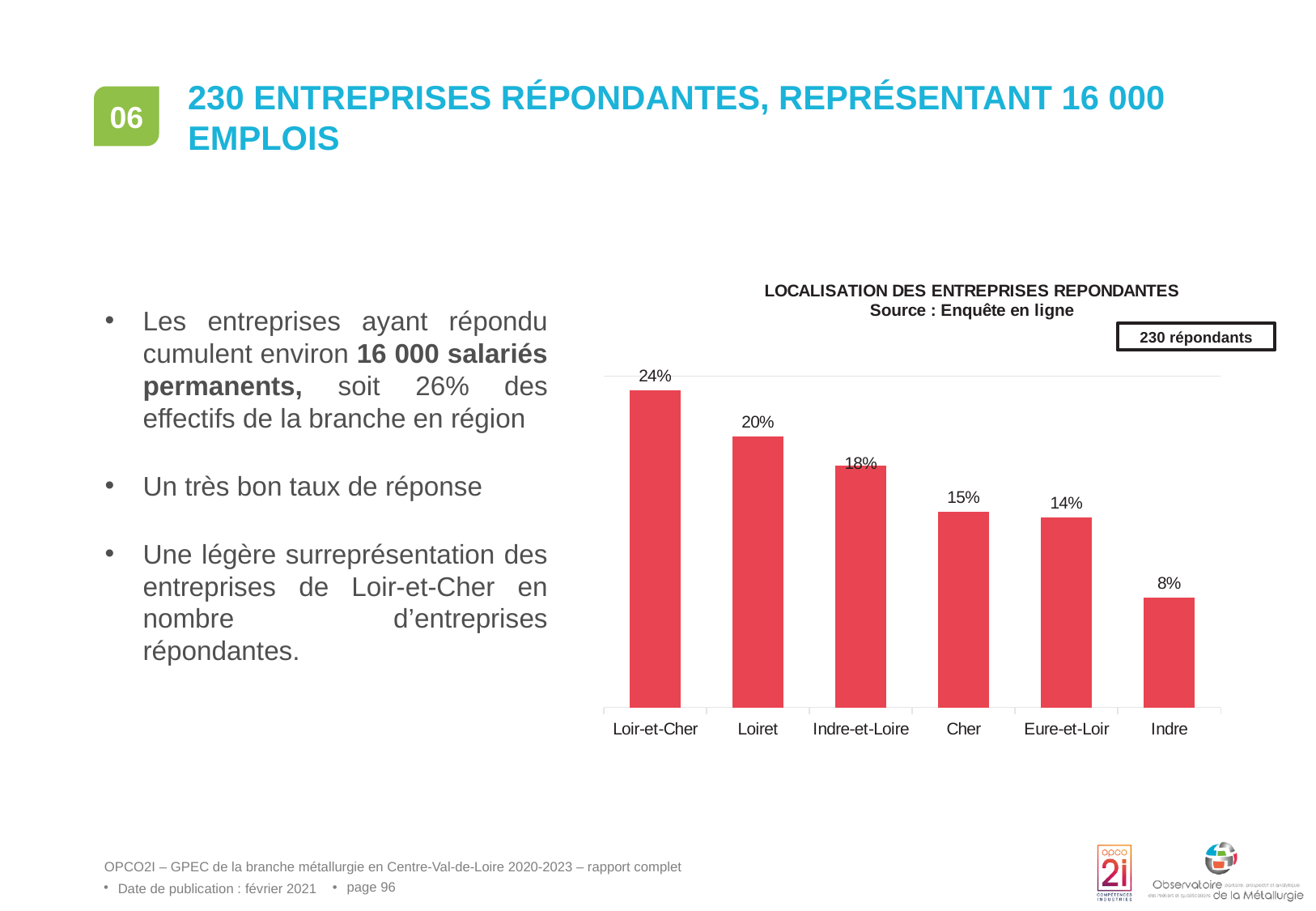
What is the difference between the values for Loir-et-Cher and Indre? 16% What is the value for Eure-et-Loir? 14% What kind of chart is shown on the slide? Bar chart What is the difference between the values for Loiret and Cher? 5% Which is larger, the value for Loiret or the value for Eure-et-Loir? Loiret What is the title of the chart? LOCALISATION DES ENTREPRISES REPONDANTES Do the values rise or fall from left to right along the x axis? Fall What is the value for Loir-et-Cher? 24% Which department has the lowest share of responding companies? Indre How many departments are shown on the chart? 6 Which department has the highest share of responding companies? Loir-et-Cher What is the value for Indre-et-Loire? 18%